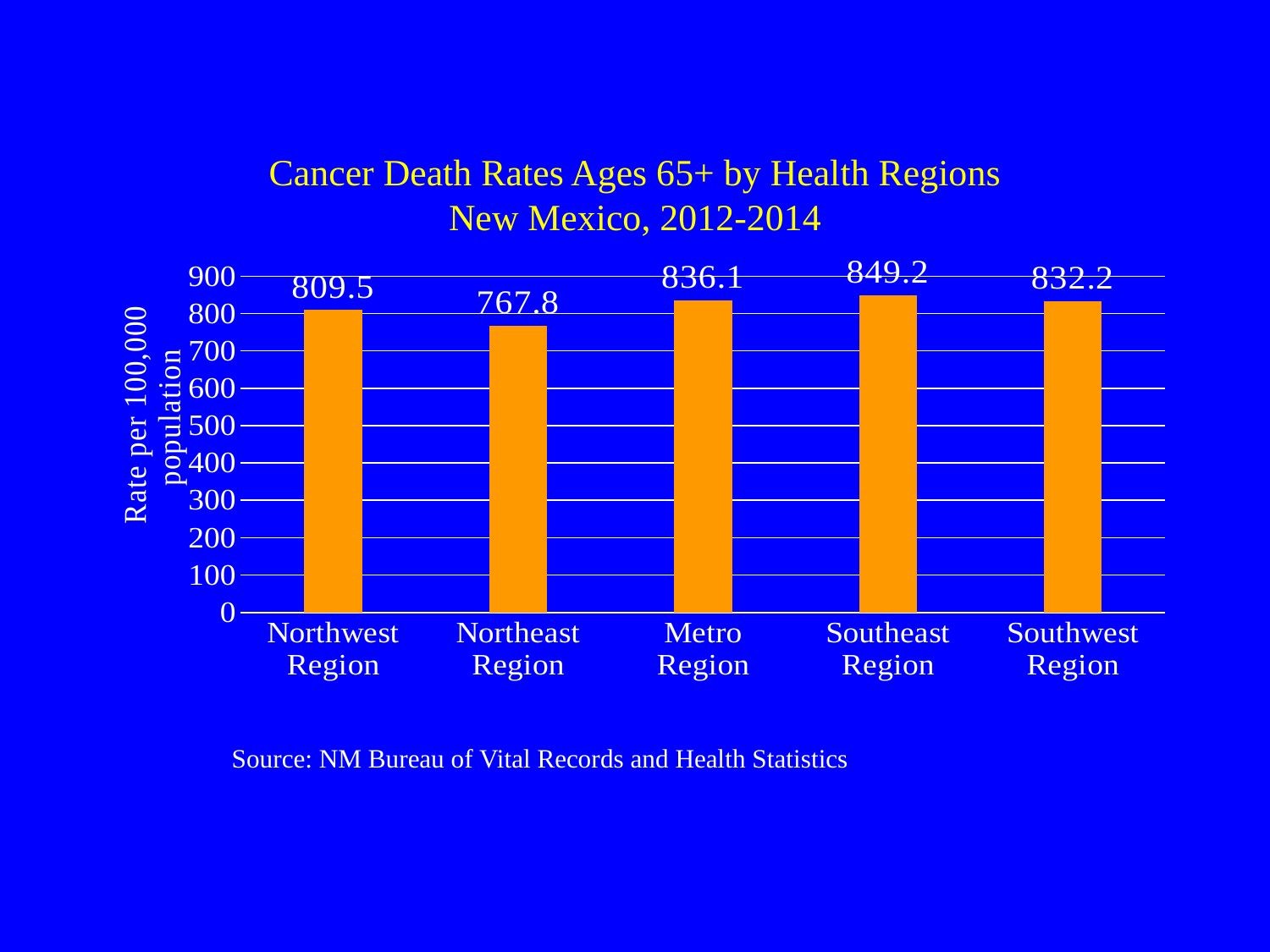
Which has a higher cancer death rate, the Metro Region or the Southwest Region? Metro Region Which region has the lowest cancer death rate? Northeast Region Which region has the highest cancer death rate? Southeast Region How many regions are shown in the chart? 5 What type of chart is shown on the slide? bar chart What is the cancer death rate for the Southeast Region? 849.2 What is the cancer death rate for the Metro Region? 836.1 What is the cancer death rate for the Northeast Region? 767.8 What is the difference between the Southeast Region and Northeast Region rates? 81.4 What is the cancer death rate for the Northwest Region? 809.5 Is the value for the Northeast Region greater or less than 800? less What is the label of the y axis? Rate per 100,000 population